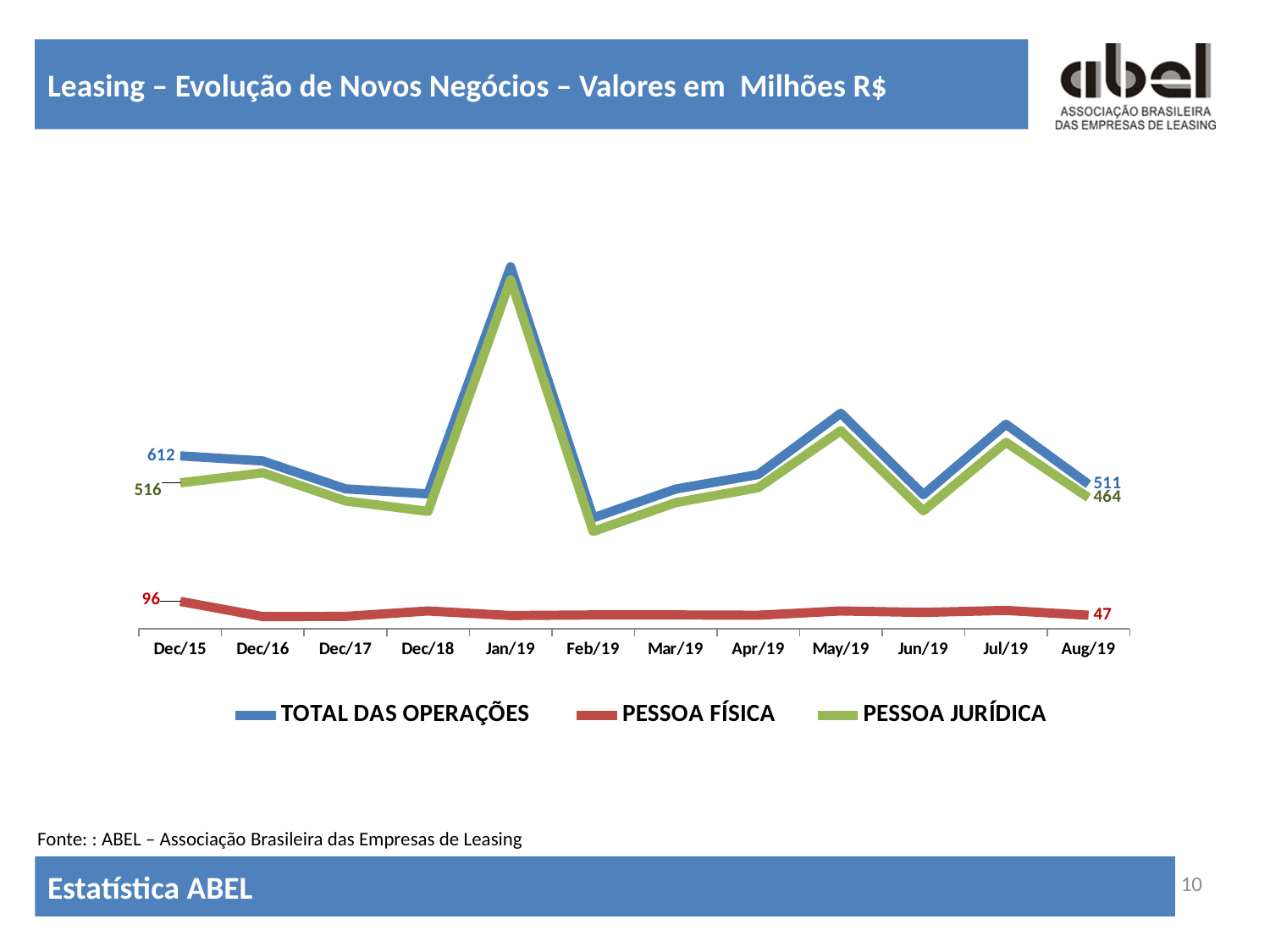
How many points are shown on the x axis? 12 What is the value of TOTAL DAS OPERAÇÕES at Dec/15? 612 At which point on the x axis does TOTAL DAS OPERAÇÕES reach its highest value? Jan/19 By how much did TOTAL DAS OPERAÇÕES fall from Dec/15 (612) to Aug/19 (511)? 101 How many series does the legend list? 3 At which point on the x axis does PESSOA JURÍDICA reach its lowest value? Feb/19 What is the value of PESSOA FÍSICA at Aug/19? 47 At Aug/19, which is larger: PESSOA JURÍDICA or PESSOA FÍSICA? PESSOA JURÍDICA What is the difference between TOTAL DAS OPERAÇÕES (612) and PESSOA JURÍDICA (516) at Dec/15? 96 What is the value of PESSOA JURÍDICA at Aug/19? 464 What kind of chart is shown on the slide? Line chart What is the value of PESSOA FÍSICA at Dec/15? 96